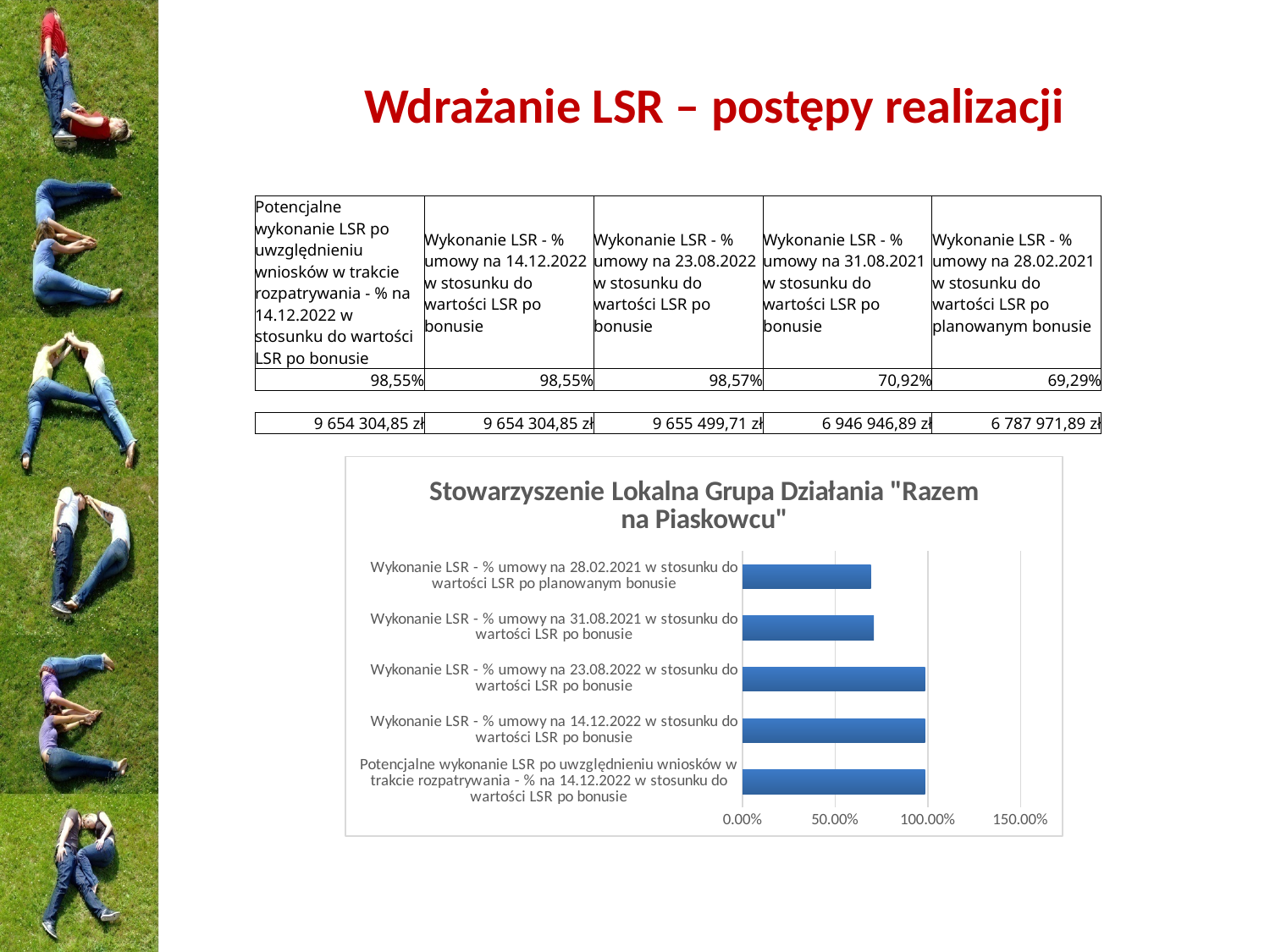
According to the table above the chart, what is the value for "Wykonanie LSR - % umowy na 31.08.2021 w stosunku do wartości LSR po bonusie"? 70,92% What is the highest tick value shown on the chart's horizontal axis? 150.00% Is the value for "Wykonanie LSR - % umowy na 23.08.2022 w stosunku do wartości LSR po bonusie" greater or less than 50.00%? greater What kind of chart is shown on the slide? bar chart According to the table above the chart, what is the value for "Wykonanie LSR - % umowy na 28.02.2021 w stosunku do wartości LSR po planowanym bonusie"? 69,29% How many categories (bars) does the chart show? 5 Is the value for "Wykonanie LSR - % umowy na 14.12.2022 w stosunku do wartości LSR po bonusie" greater or less than 150.00%? less Which is larger: the value for "Wykonanie LSR - % umowy na 23.08.2022 w stosunku do wartości LSR po bonusie" or the value for "Wykonanie LSR - % umowy na 31.08.2021 w stosunku do wartości LSR po bonusie"? Wykonanie LSR - % umowy na 23.08.2022 w stosunku do wartości LSR po bonusie What is the title of the chart? Stowarzyszenie Lokalna Grupa Działania "Razem na Piaskowcu" Is the value for "Wykonanie LSR - % umowy na 28.02.2021 w stosunku do wartości LSR po planowanym bonusie" greater or less than 100.00%? less Which is larger: the value for "Wykonanie LSR - % umowy na 28.02.2021 w stosunku do wartości LSR po planowanym bonusie" or the value for "Wykonanie LSR - % umowy na 14.12.2022 w stosunku do wartości LSR po bonusie"? Wykonanie LSR - % umowy na 14.12.2022 w stosunku do wartości LSR po bonusie